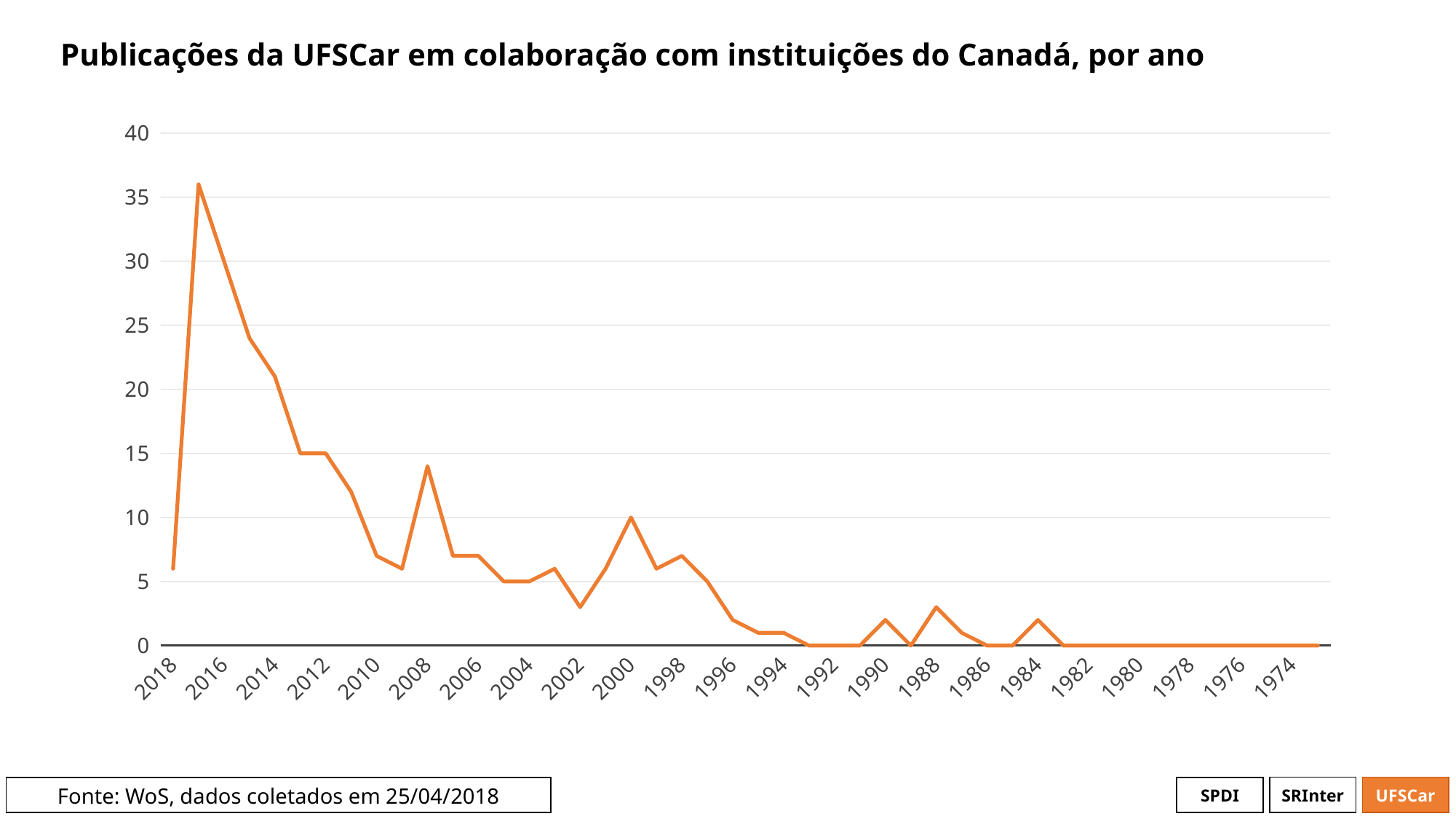
What kind of chart is shown on the slide? line chart Is the value for 2008 greater or less than 10? greater Which year has the larger value, 2008 or 2000? 2008 What is the value for the year 1992? 0 What is the title of the chart? Publicações da UFSCar em colaboração com instituições do Canadá, por ano What is the value for the year 2004? 5 What is the value for the year 2000? 10 Is the value for 2018 greater or less than 10? less What is the value for the year 2012? 15 What is the difference between the values for 2012 and 2004? 10 Moving from left to right along the x axis (from 2018 toward 1974), do the values generally rise or fall? fall